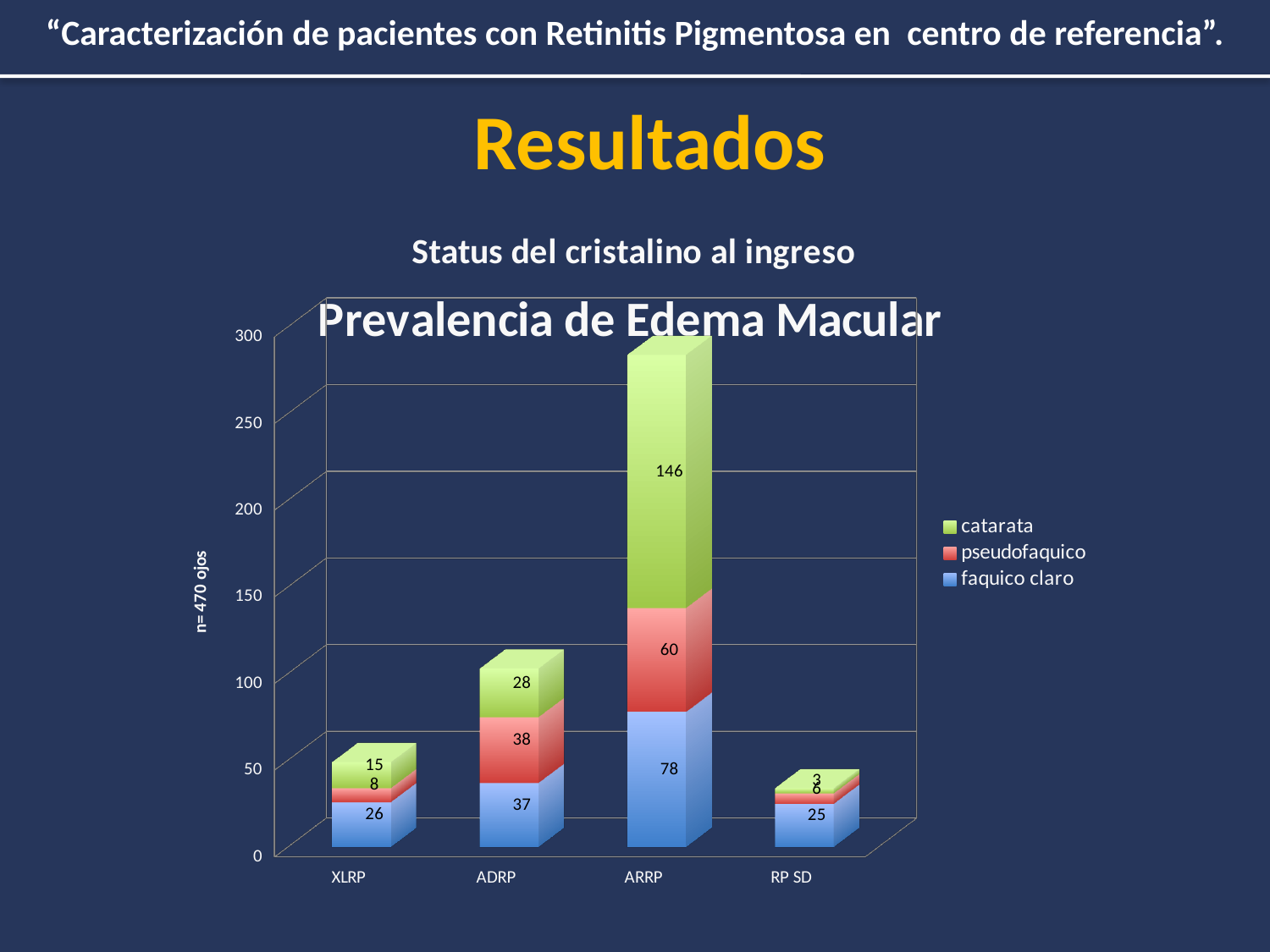
What is the value of faquico claro for ADRP? 37 How many series does the legend list? 3 Which is larger, the pseudofaquico value for ARRP or the pseudofaquico value for ADRP? ARRP What is the value of pseudofaquico for XLRP? 8 What is the difference between the catarata value for ARRP and the catarata value for ADRP? 118 How many categories are shown on the x axis? 4 What is the value of catarata for ARRP? 146 What is the total of the stacked bar for XLRP? 49 Which category has the tallest stacked bar overall? ARRP Is the total height of the ARRP bar greater or less than 250? greater What is the total of the stacked bar for ADRP? 103 Which category has the highest catarata value? ARRP